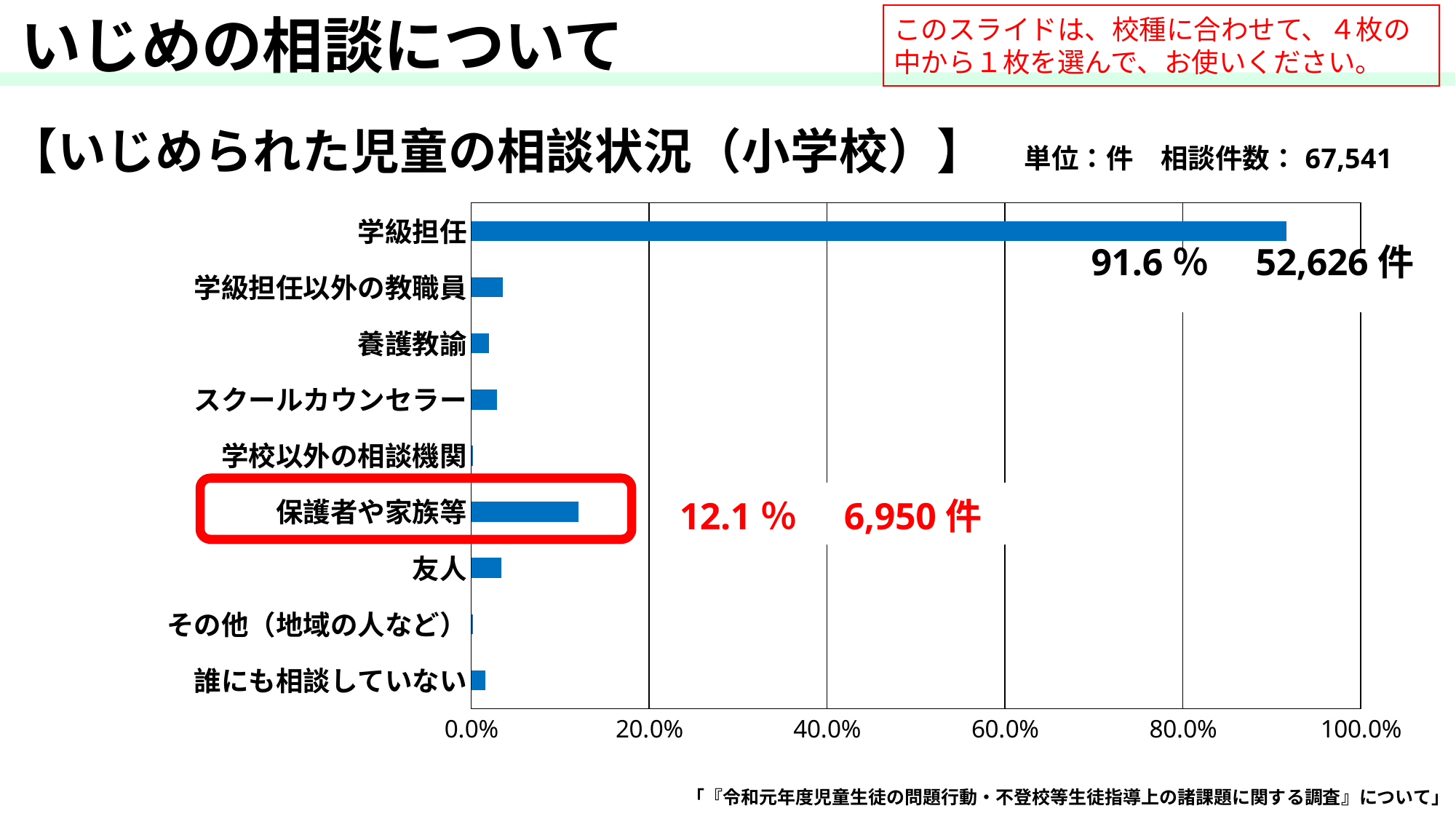
Which category is highlighted with a red box in the chart? 保護者や家族等 What percentage is shown for 保護者や家族等? 12.1 % Is the value for 学級担任以外の教職員 greater or less than 20.0%? less How many cases (件) are shown for 学級担任? 52,626 件 What kind of chart is shown on the slide? bar chart What percentage is shown for 学級担任? 91.6 % Which category has the highest value in the chart? 学級担任 How many categories are shown in the chart? 9 What is the difference in the number of cases between 学級担任 and 保護者や家族等? 45,676 件 What is the difference in percentage between 学級担任 and 保護者や家族等? 79.5 % Which is larger, the value for 保護者や家族等 or the value for 友人? 保護者や家族等 How many cases (件) are shown for 保護者や家族等? 6,950 件